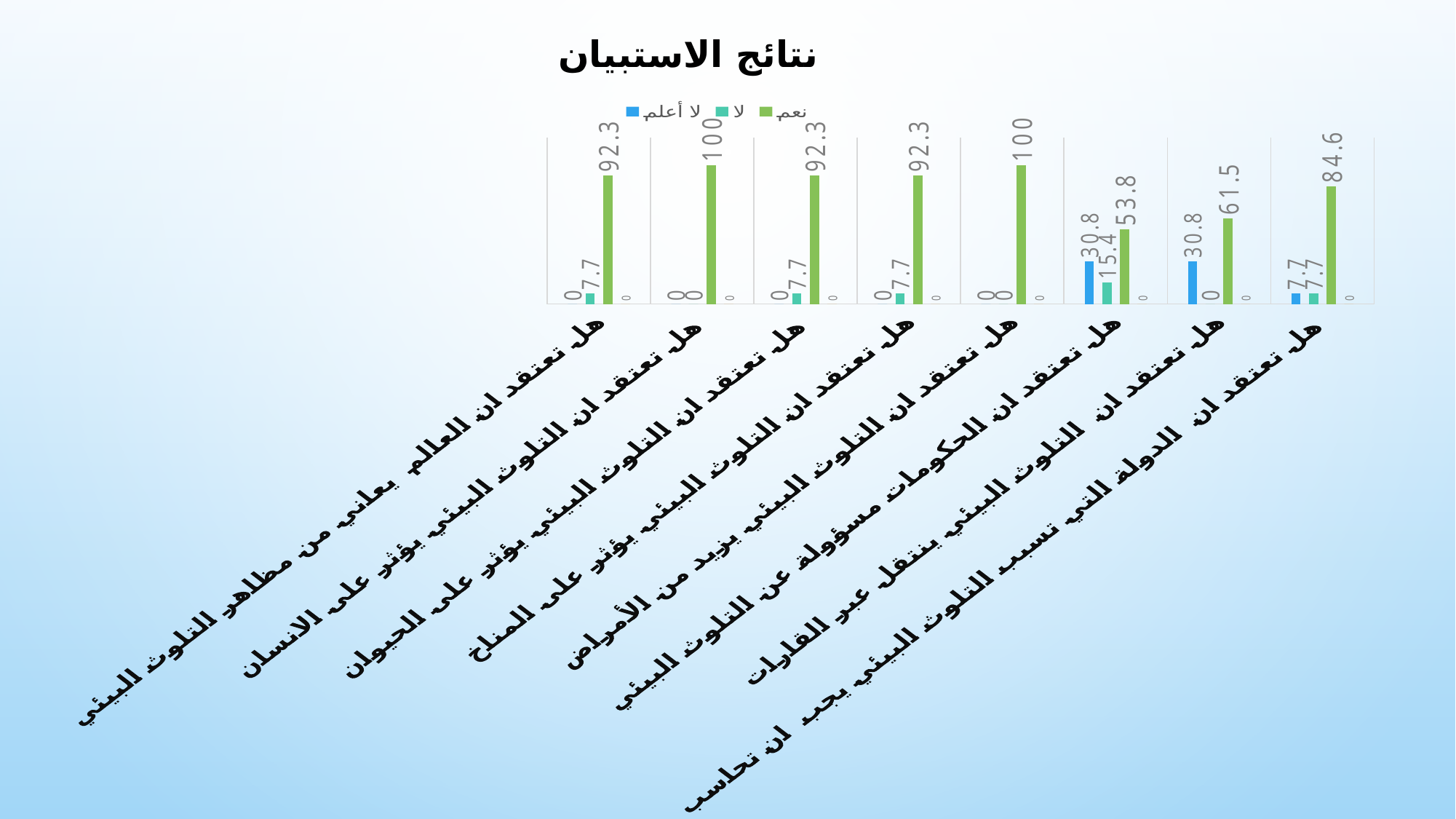
Which is larger for the question هل تعتقد ان الحكومات مسؤولة عن التلوث البيئي: the لا أعلم value or the لا value? لا أعلم What is the value of لا أعلم for the question هل تعتقد ان التلوث البيئي ينتقل عبر القارات? 30.8 What colour are the نعم bars? green How many question categories are shown on the x axis? 8 What is the value of نعم for the question هل تعتقد ان الحكومات مسؤولة عن التلوث البيئي? 53.8 What is the difference between the نعم values for هل تعتقد ان التلوث البيئي يؤثر على الانسان and هل تعتقد ان التلوث البيئي ينتقل عبر القارات? 38.5 What is the value of لا for the question هل تعتقد ان الحكومات مسؤولة عن التلوث البيئي? 15.4 Which question has the lowest نعم value? هل تعتقد ان الحكومات مسؤولة عن التلوث البيئي What is the value of نعم for the question هل تعتقد ان الدولة التي تسبب التلوث البيئي يجب ان تحاسب? 84.6 How many series does the legend list? 3 What type of chart is shown on the slide? bar chart What is the title of the chart? نتائج الاستبيان